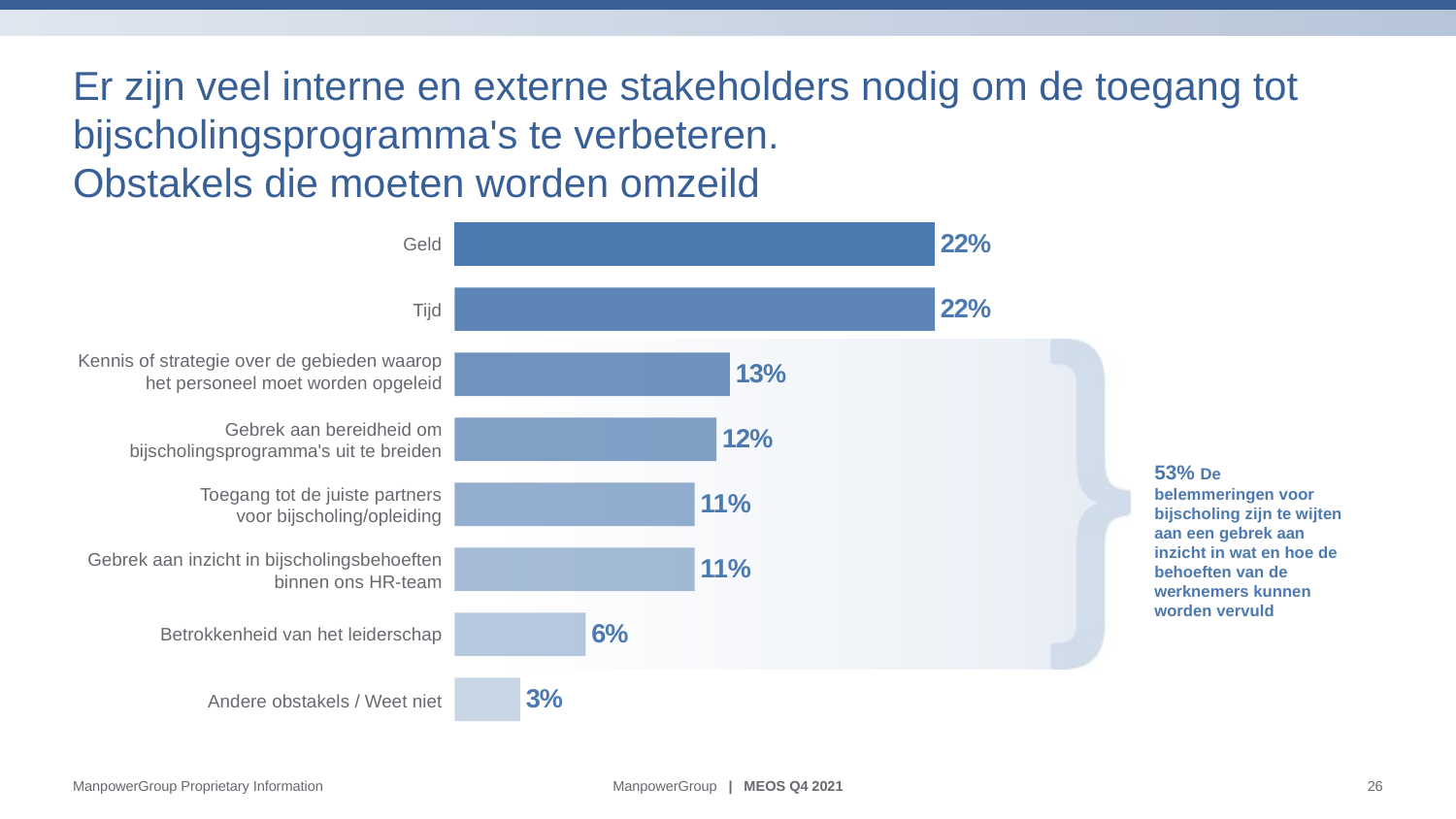
What is the difference between the values for Tijd and Betrokkenheid van het leiderschap? 16% What is the difference between the values for Kennis of strategie over de gebieden waarop het personeel moet worden opgeleid and Toegang tot de juiste partners voor bijscholing/opleiding? 2% What is the total of the values for Toegang tot de juiste partners voor bijscholing/opleiding and Gebrek aan inzicht in bijscholingsbehoeften binnen ons HR-team? 22% What is the value for Andere obstakels / Weet niet? 3% What is the value for Gebrek aan bereidheid om bijscholingsprogramma's uit te breiden? 12% Which category has the lowest value? Andere obstakels / Weet niet What is the value for Geld? 22% What is the value for Betrokkenheid van het leiderschap? 6% What percentage does the callout next to the bracket on the right of the chart state? 53% How many categories are shown in the chart? 8 What kind of chart is shown on the slide? Bar chart Which is larger: the value for Geld or the value for Betrokkenheid van het leiderschap? Geld